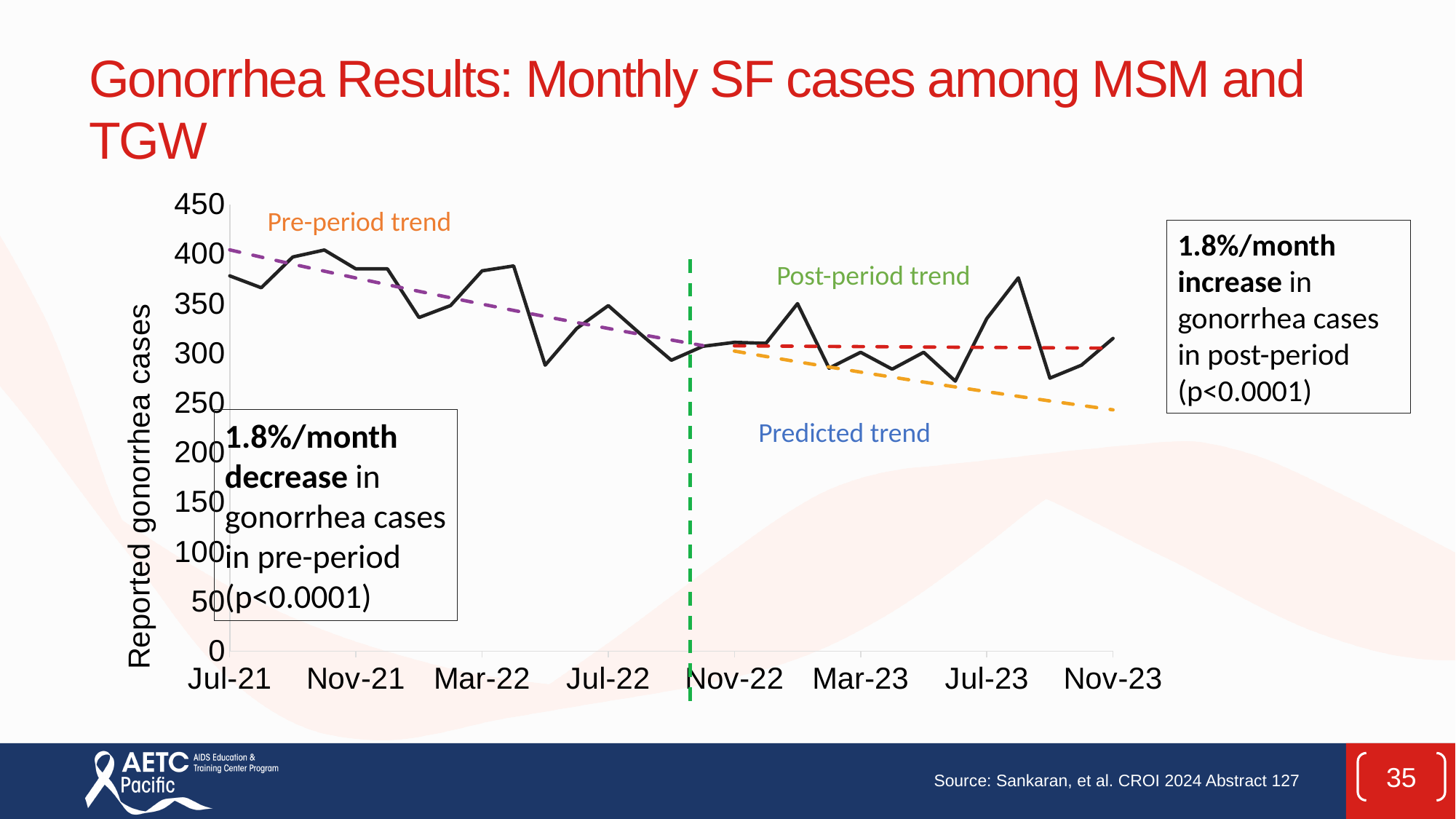
Which has more reported gonorrhea cases, Jul-21 or Nov-23? Jul-21 Is the value for Nov-23 greater or less than 350? less Does the predicted trend line rise or fall after Nov-22? fall What is the label of the y axis? Reported gonorrhea cases Does the pre-period trend line rise or fall from Jul-21 to Nov-22? fall According to the annotation, what is the monthly percentage change in gonorrhea cases in the post-period? 1.8%/month increase What is the highest value shown on the y axis? 450 Is the value for Jul-21 greater or less than 350? greater Is the value for Mar-23 greater or less than 350? less How many month labels are shown on the x axis? 8 What kind of chart is shown on the slide? line chart